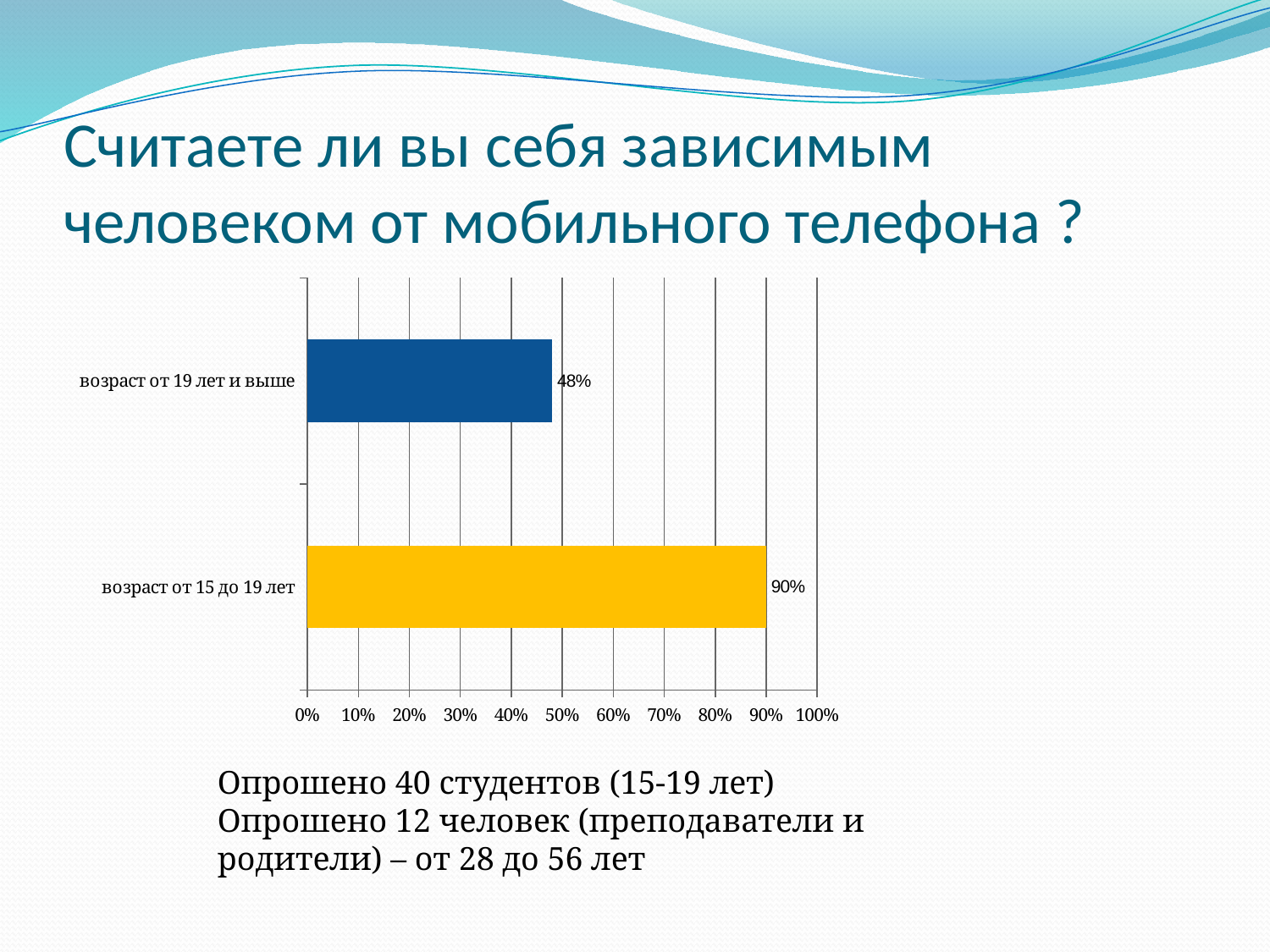
What kind of chart is shown on the slide? bar chart What colour is the bar for "возраст от 15 до 19 лет"? yellow Which category has the highest value? возраст от 15 до 19 лет Which category has the lowest value? возраст от 19 лет и выше Is the value for "возраст от 15 до 19 лет" greater or less than 80%? greater What is the value for the category "возраст от 19 лет и выше"? 48% What is the value for the category "возраст от 15 до 19 лет"? 90% Is the value for "возраст от 19 лет и выше" greater or less than 50%? less What is the difference between the values for "возраст от 15 до 19 лет" and "возраст от 19 лет и выше"? 42% What is the maximum value shown on the horizontal axis? 100% Which is larger: the value for "возраст от 15 до 19 лет" or for "возраст от 19 лет и выше"? возраст от 15 до 19 лет How many categories are shown in the chart? 2